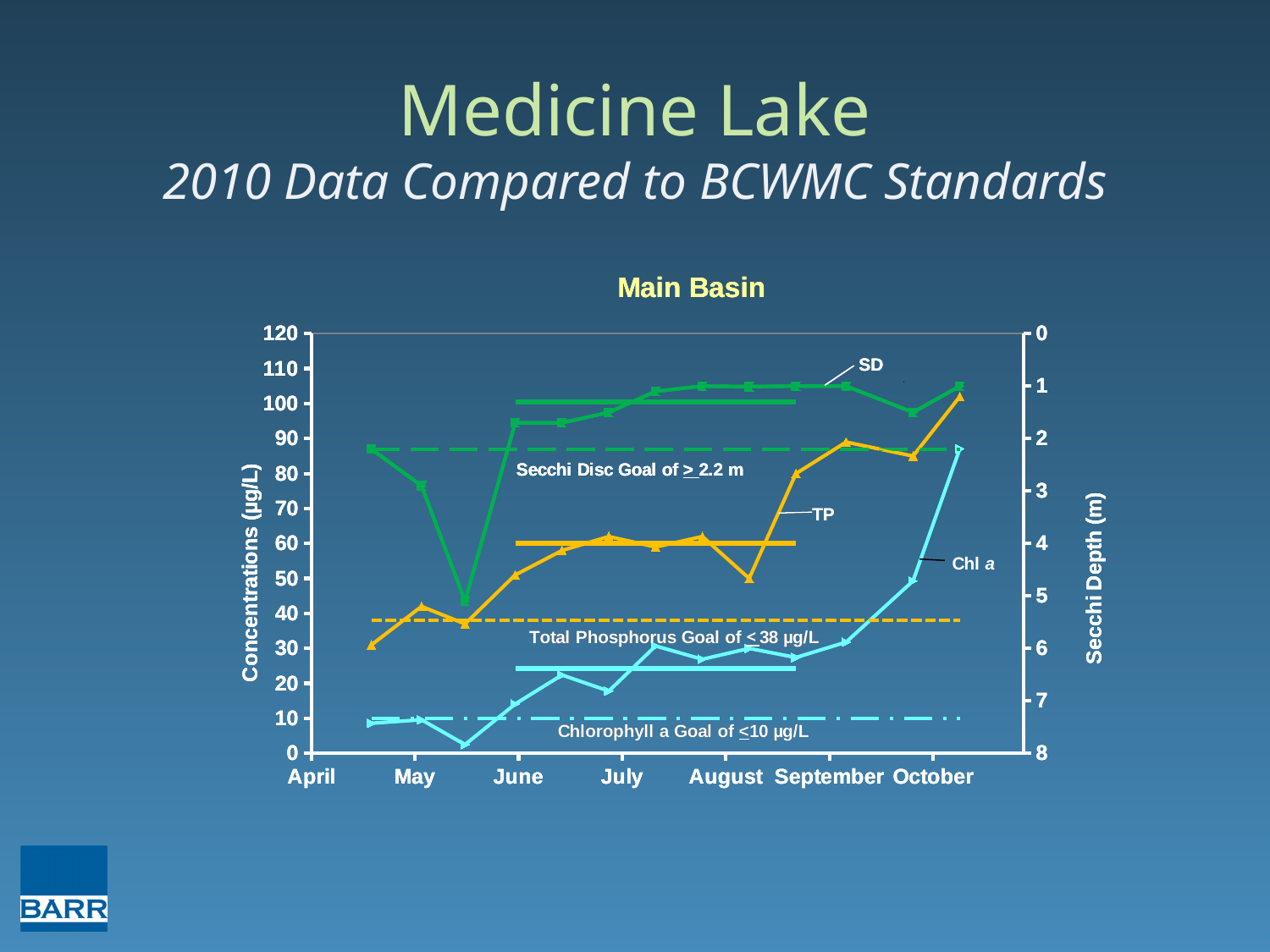
Is the TP value at the first point in late April greater or less than 40 µg/L? less What is the title of the chart? Main Basin What is the Chlorophyll a goal stated on the chart? ≤ 10 µg/L What kind of chart is shown on the slide? line chart Does the TP series generally rise or fall from April to October? rise What is the Total Phosphorus goal stated on the chart? ≤ 38 µg/L Is the Chl a value at the last point in October greater or less than 80 µg/L? greater Is the TP value at the last point in October greater or less than 90 µg/L? greater How many months are labelled along the x axis? 7 What is the Secchi Disc goal stated on the chart? ≥ 2.2 m What is the label of the left vertical axis? Concentrations (µg/L)